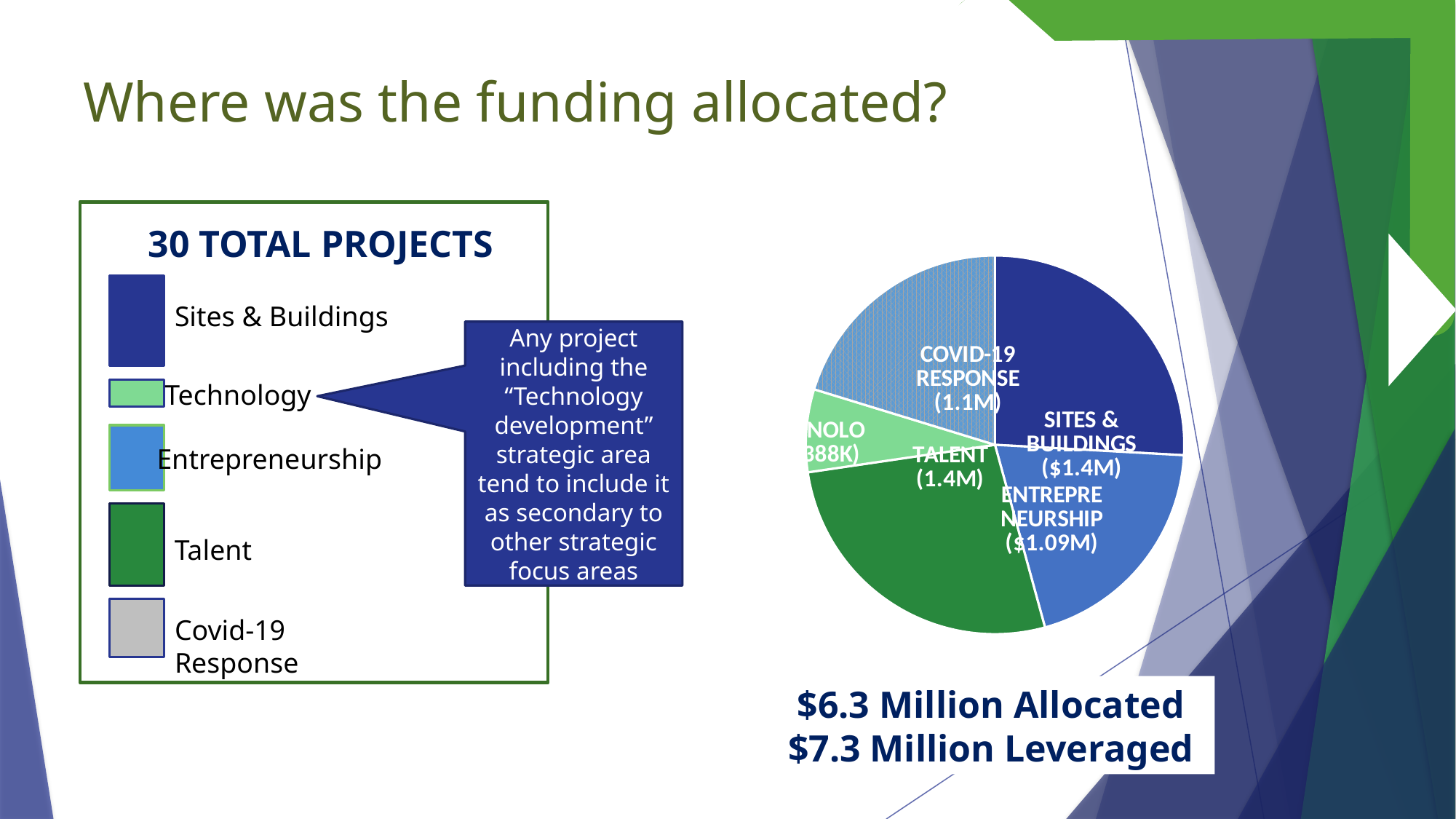
Which category has the smallest slice in the pie chart? Technology What amount is shown for Sites & Buildings in the pie chart? $1.4M What total amount allocated is stated below the pie chart? $6.3 Million What kind of chart is shown on the slide? pie chart Which is larger in the pie chart, Sites & Buildings or Entrepreneurship? Sites & Buildings How many slices does the pie chart have? 5 How many total projects does the legend box state? 30 What amount is shown for Entrepreneurship in the pie chart? $1.09M How many categories does the legend on the left list? 5 What amount is shown for COVID-19 Response in the pie chart? 1.1M What amount is shown for Talent in the pie chart? 1.4M What is the difference between the Talent and COVID-19 Response amounts in the pie chart? 0.3M